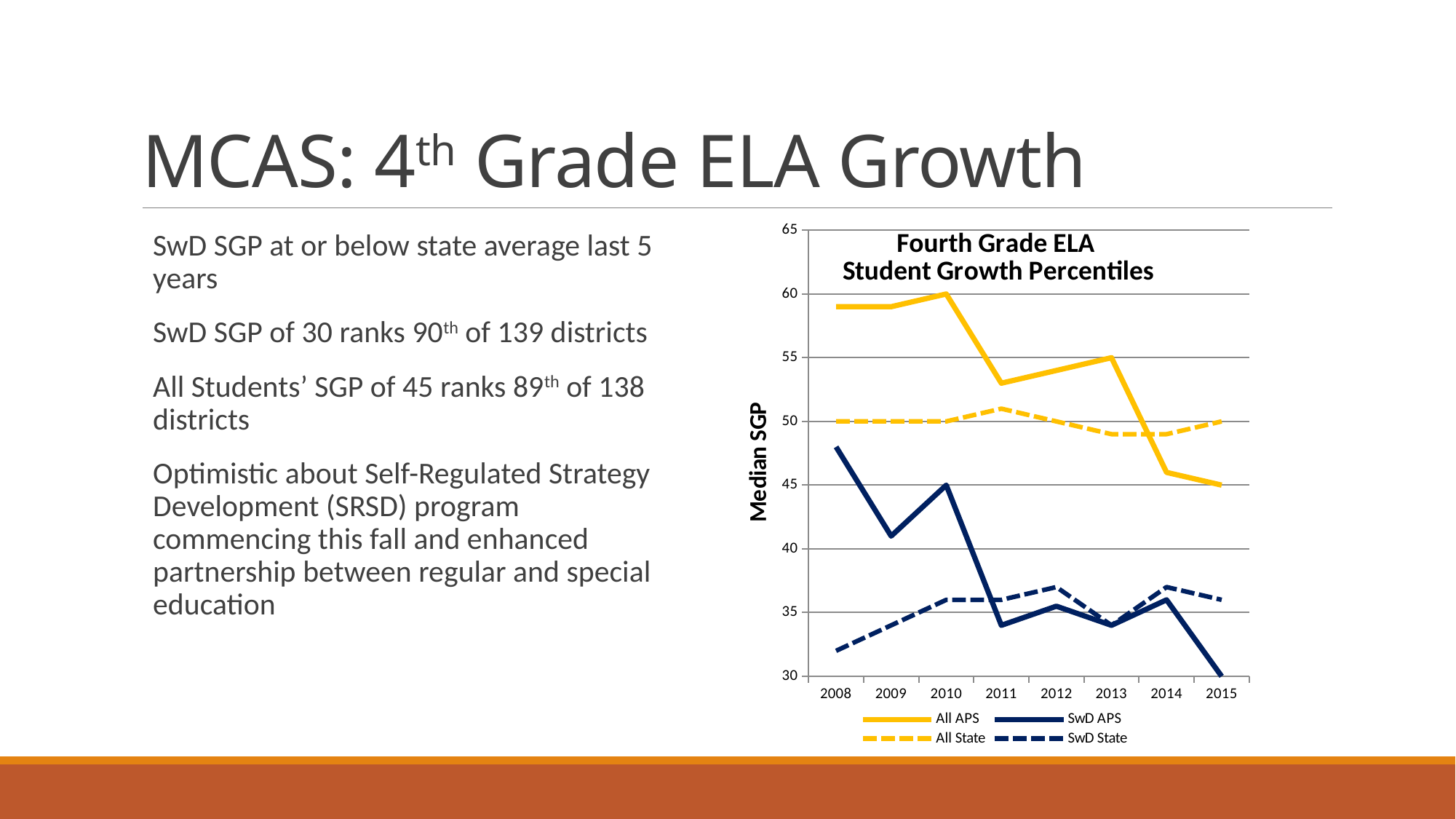
What is the SwD APS value in 2015? 30 Is the SwD State value for 2008 greater or less than 35? less Which series has the larger value in 2008, All APS or All State? All APS What is the All APS value in 2010? 60 How many years are plotted along the x axis of the chart? 8 What kind of chart is shown on the slide? line chart In which year does the SwD APS series reach its lowest value? 2015 How many series does the chart legend list? 4 What is the title of the chart? Fourth Grade ELA Student Growth Percentiles Is the SwD APS value for 2008 greater or less than 45? greater What is the label on the vertical axis of the chart? Median SGP In which year does the All APS series reach its highest value? 2010